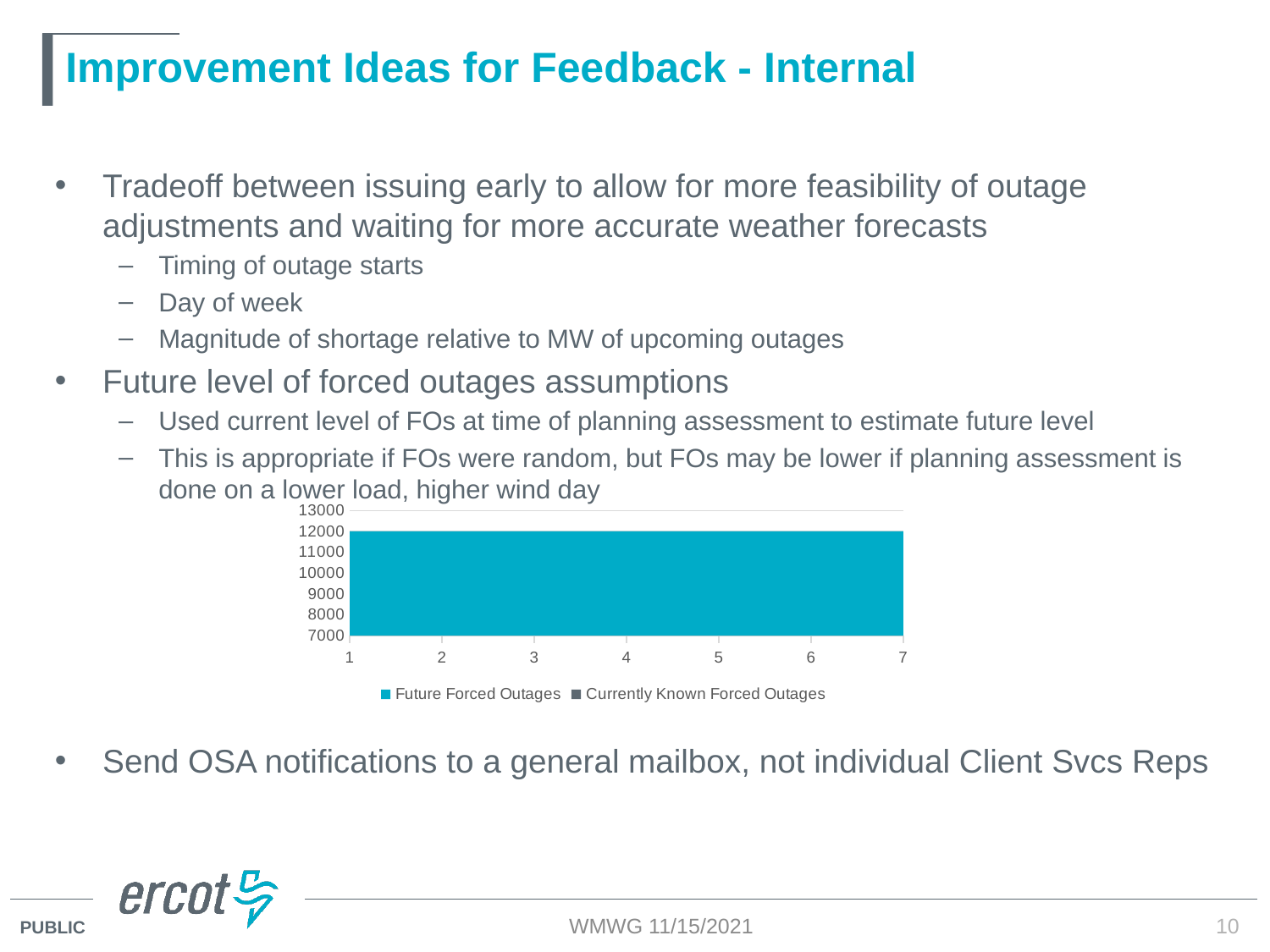
Is the plotted value at x = 1 greater or less than 11000? greater What kind of chart is shown on the slide? area chart What is the highest value shown on the chart's y axis? 13000 What is the lowest value shown on the chart's y axis? 7000 Is the plotted value at x = 4 greater or less than 10000? greater How many series does the chart legend list? 2 Do the plotted values rise, fall, or stay flat from x = 1 to x = 7? stay flat Is the plotted value at x = 7 greater or less than 13000? less What are the two series named in the chart legend? Future Forced Outages and Currently Known Forced Outages How many points are labelled along the x axis of the chart? 7